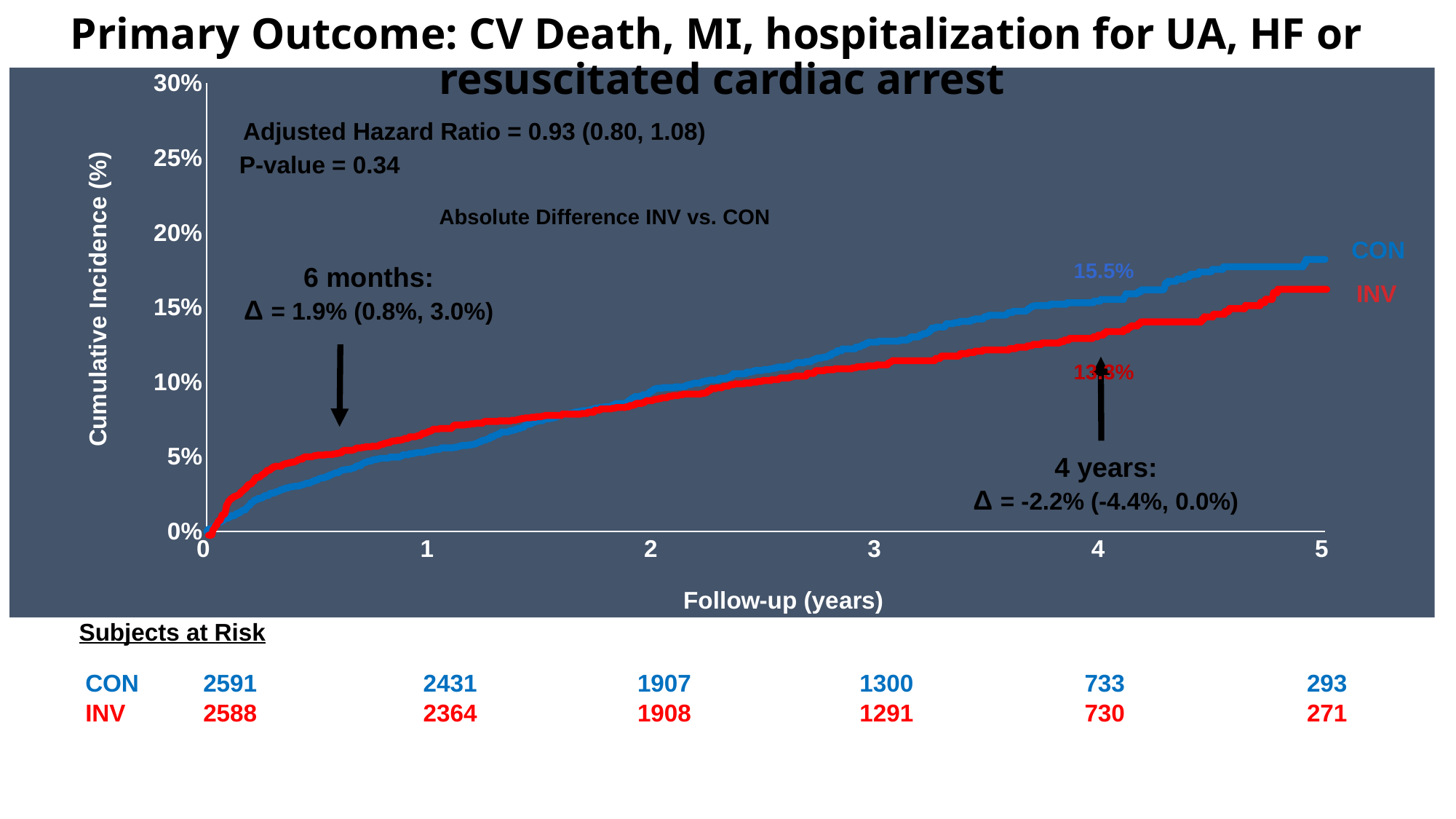
What kind of chart is shown on the slide? line chart Is the cumulative incidence for CON at 5 years greater or less than 15%? greater How many CON subjects are at risk at year 0 according to the Subjects at Risk table? 2591 Do the cumulative incidence curves rise or fall as follow-up time increases? rise What is the absolute difference INV vs. CON at 4 years, as printed on the chart? -2.2% (-4.4%, 0.0%) What P-value is printed on the chart? 0.34 At 6 months of follow-up, which curve shows the higher cumulative incidence, CON or INV? INV What is the cumulative incidence for CON at 4 years, as labelled on the chart? 15.5% How many series (groups) are plotted on the chart? 2 What adjusted hazard ratio is printed on the chart? 0.93 (0.80, 1.08) At 4 years of follow-up, which curve shows the higher cumulative incidence, CON or INV? CON What is the absolute difference INV vs. CON at 6 months, as printed on the chart? 1.9% (0.8%, 3.0%)